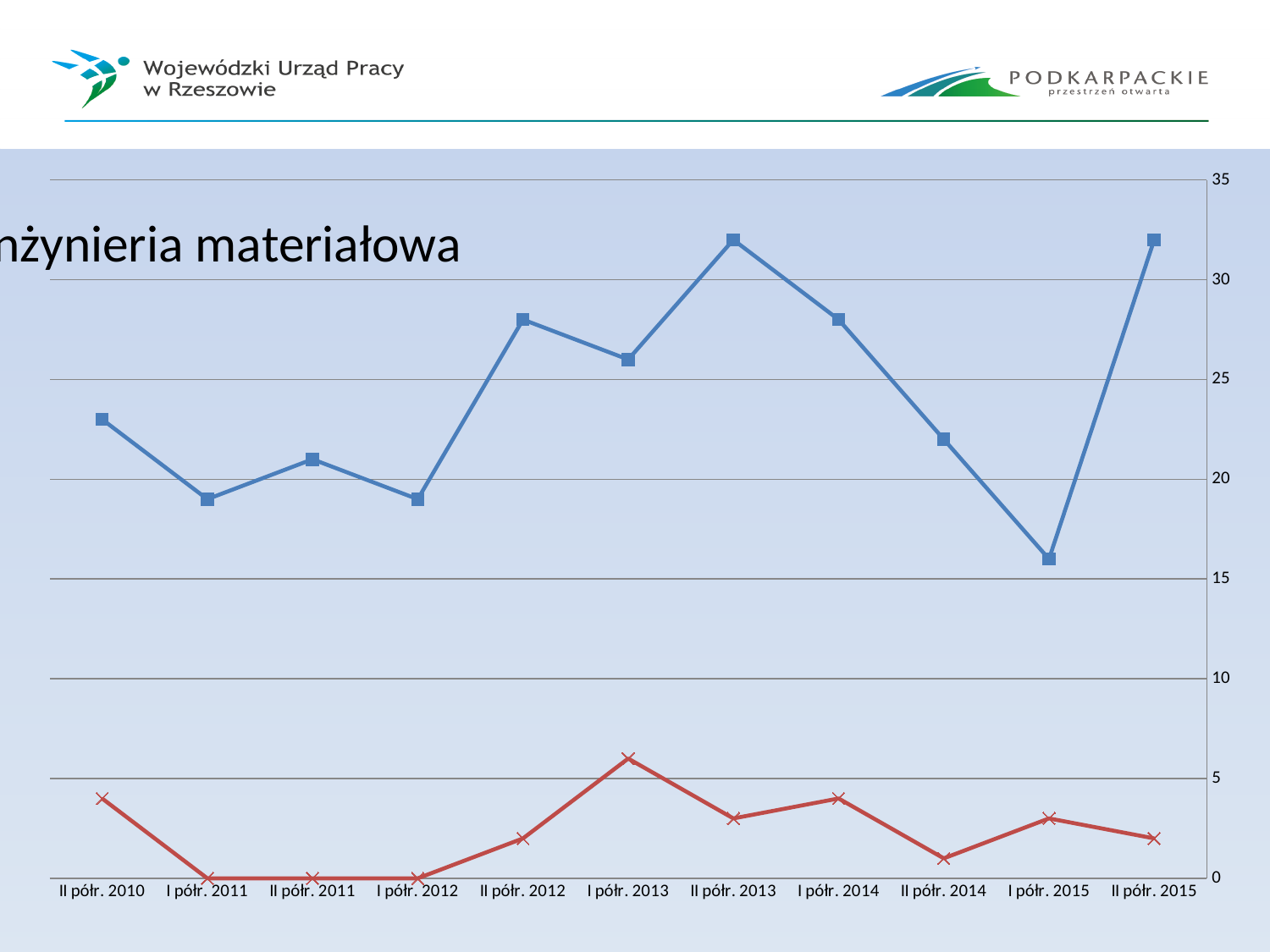
In which period does the blue line (square markers) reach its lowest value? I półr. 2015 Does the blue line rise or fall between II półr. 2013 and I półr. 2015? fall What is the highest value shown on the vertical axis of the chart? 35 How many lines are plotted on the chart? 2 Which is larger for the blue line: the value at I półr. 2014 or the value at II półr. 2014? I półr. 2014 Is the value of the red line at I półr. 2013 greater or less than 5? greater Is the value of the blue line at II półr. 2013 greater or less than 30? greater What is the value of the red line (x markers) at I półr. 2011? 0 In which period does the red line (x markers) reach its highest value? I półr. 2013 How many time periods are shown on the x axis of the chart? 11 Is the value of the blue line at I półr. 2015 greater or less than 20? less What kind of chart is shown on the slide? line chart